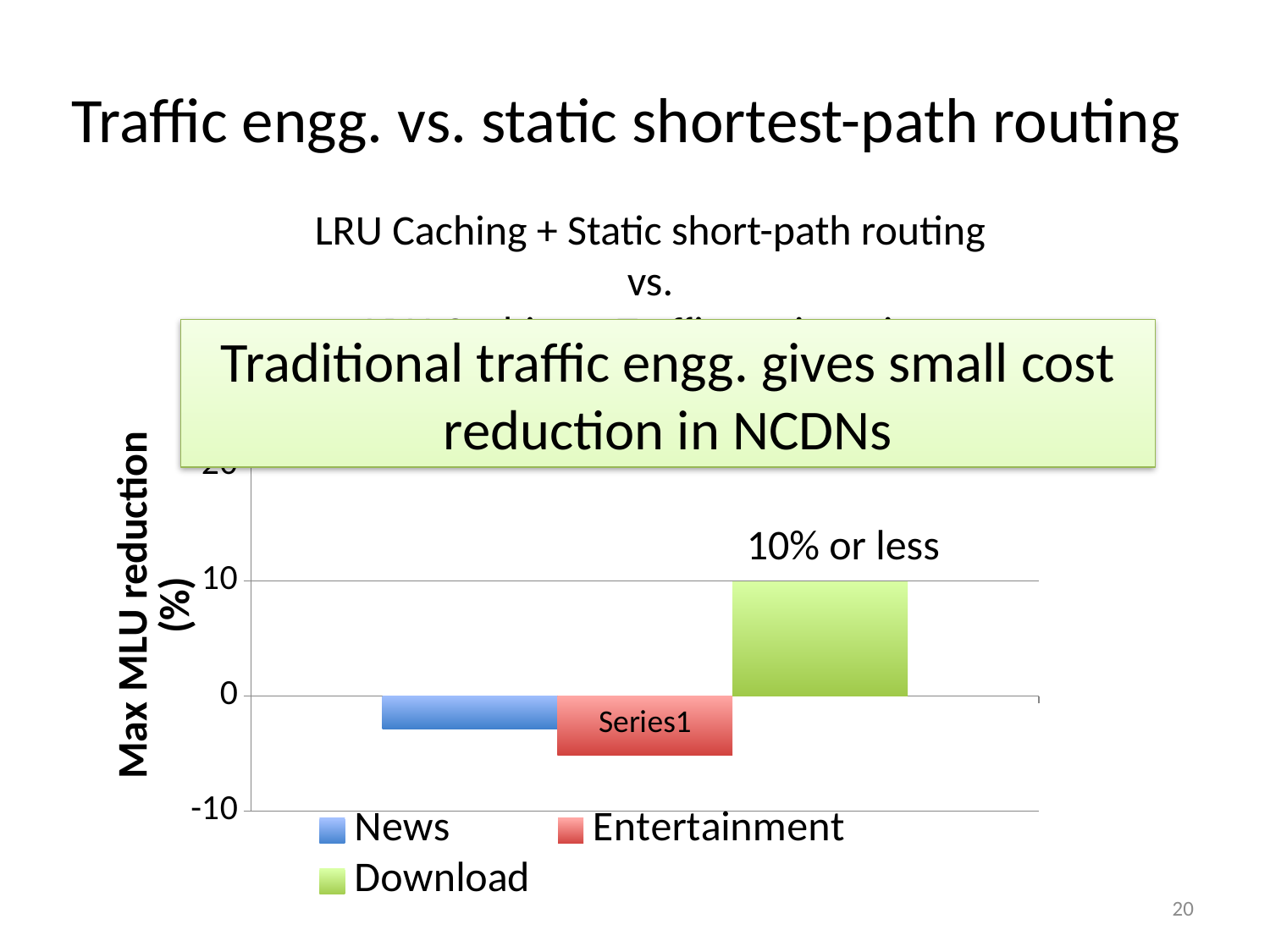
Is the value for Download greater or less than 0? greater Is the value for Download greater or less than 20? less How many series does the chart legend list? 3 What is the label on the vertical axis of the chart? Max MLU reduction (%) Which has the larger Max MLU reduction, News or Entertainment? News Which series has the lowest Max MLU reduction? Entertainment Is the value for News greater or less than -10? greater Which colour represents Download in the chart legend? green Which has the larger Max MLU reduction, Download or News? Download What kind of chart is shown on the slide? bar chart Which series has the highest Max MLU reduction? Download